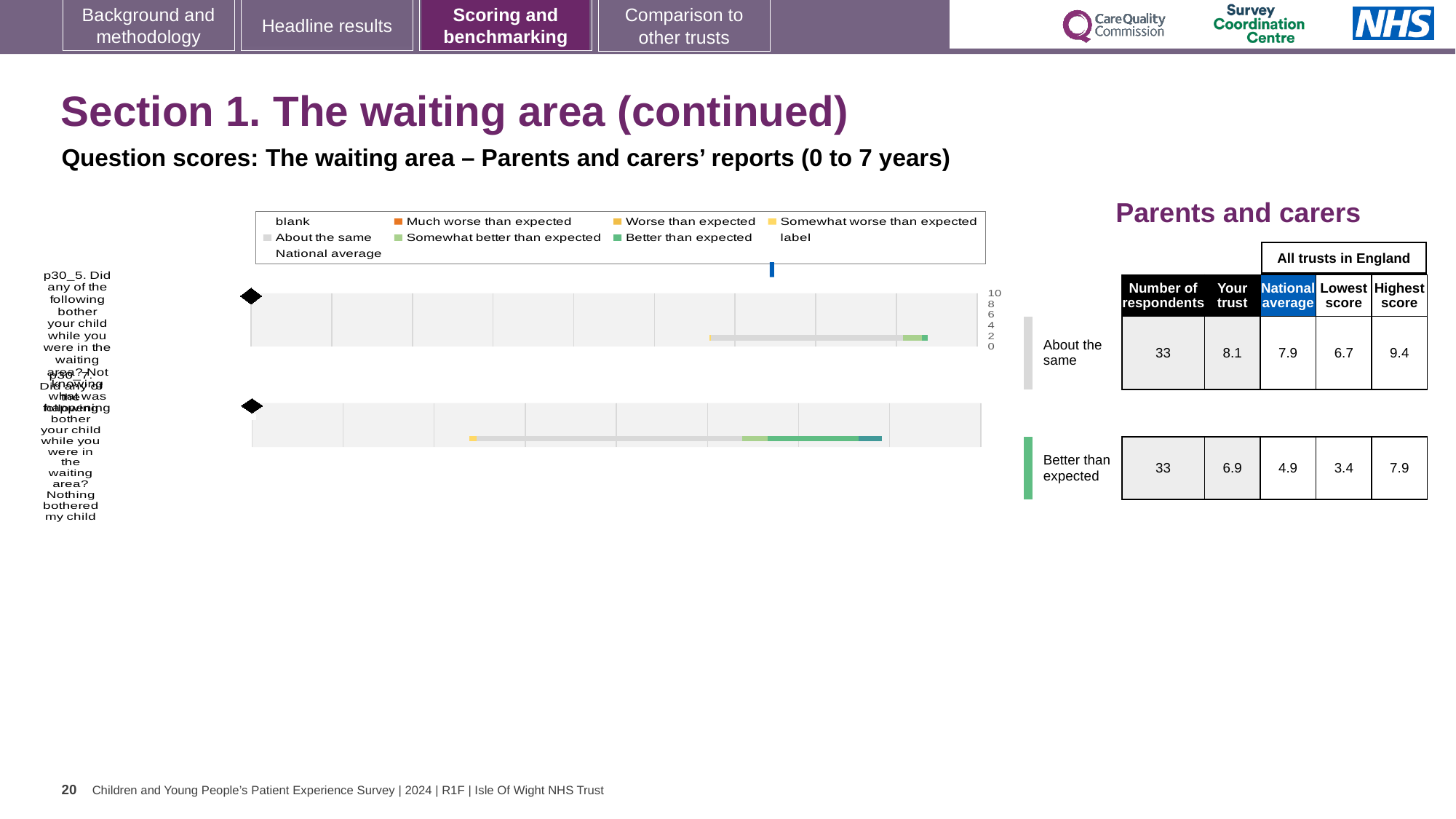
What is the lowest score among all trusts in England for the question rated 'About the same'? 6.7 What is the highest value shown on the chart's axis? 10 What kind of chart is shown on the slide? bar chart Which benchmark category is shown for question p30_5 (Did any of the following bother your child while you were in the waiting area? Not knowing what was happening)? About the same For the question rated 'Better than expected', which is larger: the 'Your trust' score or the national average? Your trust How many respondents answered the question rated 'About the same'? 33 What is the difference between the 'Your trust' score and the national average for the question rated 'Better than expected'? 2.0 Which benchmark category is shown for question p30_7 (Nothing bothered my child)? Better than expected What is the national average score for the question rated 'Better than expected'? 4.9 What is the 'Your trust' score for the question rated 'About the same'? 8.1 How many questions (bars) are plotted in the chart? 2 What is the highest score among all trusts in England for the question rated 'Better than expected'? 7.9